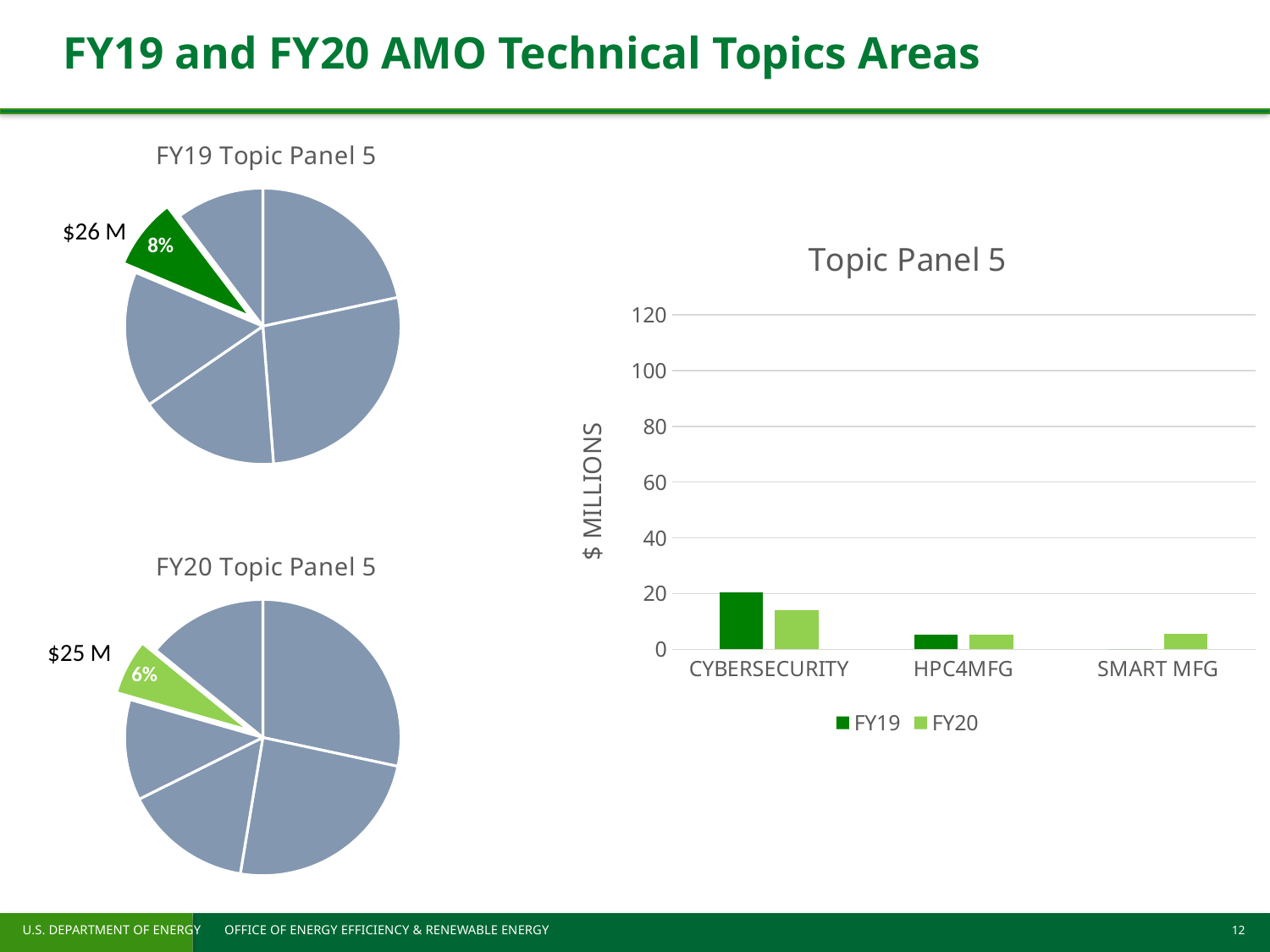
What kind of chart is the Topic Panel 5 chart on the right of the slide? Bar chart What is the label on the vertical axis of the Topic Panel 5 bar chart? $ MILLIONS In the FY20 Topic Panel 5 pie chart, what share does the highlighted green slice represent? 6% In the Topic Panel 5 bar chart, is the FY20 value for CYBERSECURITY greater or less than 20? less In the FY20 Topic Panel 5 pie chart, what dollar amount is labelled next to the highlighted slice? $25 M In the FY19 Topic Panel 5 pie chart, what dollar amount is labelled next to the highlighted slice? $26 M In the Topic Panel 5 bar chart, which is larger for CYBERSECURITY: the FY19 value or the FY20 value? FY19 In the Topic Panel 5 bar chart, which category has the highest FY19 value? CYBERSECURITY In the Topic Panel 5 bar chart, how many categories are shown on the x axis? 3 In the FY19 Topic Panel 5 pie chart, what share does the highlighted green slice represent? 8% Which highlighted slice has the larger percentage share: the one in the FY19 Topic Panel 5 pie or the one in the FY20 Topic Panel 5 pie? FY19 Topic Panel 5 In the Topic Panel 5 bar chart, how many series does the legend list? 2